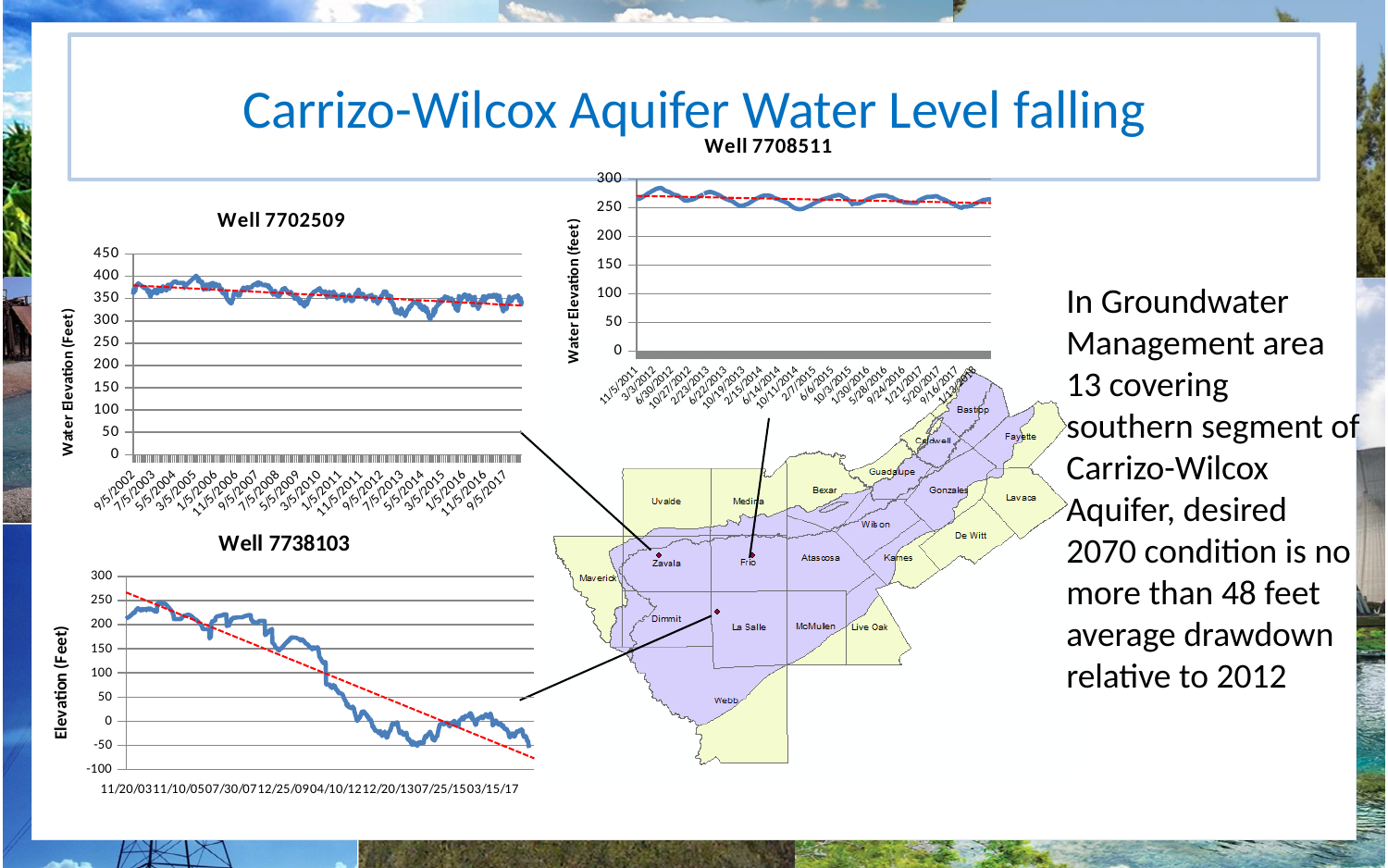
What kind of chart is used for Well 7702509? line chart In the Well 7708511 chart, is the water elevation at 11/5/2011 greater or less than 200? greater In the Well 7702509 chart, do the water elevation values rise or fall over time along the x axis? fall In the Well 7738103 chart, which is larger: the elevation at the start of the series or at the end of the series? the start of the series In the Well 7702509 chart, is the water elevation at the start of the series (9/5/2002) greater or less than 350? greater In the Well 7738103 chart, is the elevation at the end of the series (2017) greater or less than 0? less In the Well 7708511 chart, do the water elevation values generally rise or fall over time? fall What is the title of the slide containing the well charts? Carrizo-Wilcox Aquifer Water Level falling How many charts of well water levels are shown on the slide? 3 In the Well 7738103 chart, do the elevation values rise or fall over time along the x axis? fall What is the y-axis label of the Well 7738103 chart? Elevation (Feet)